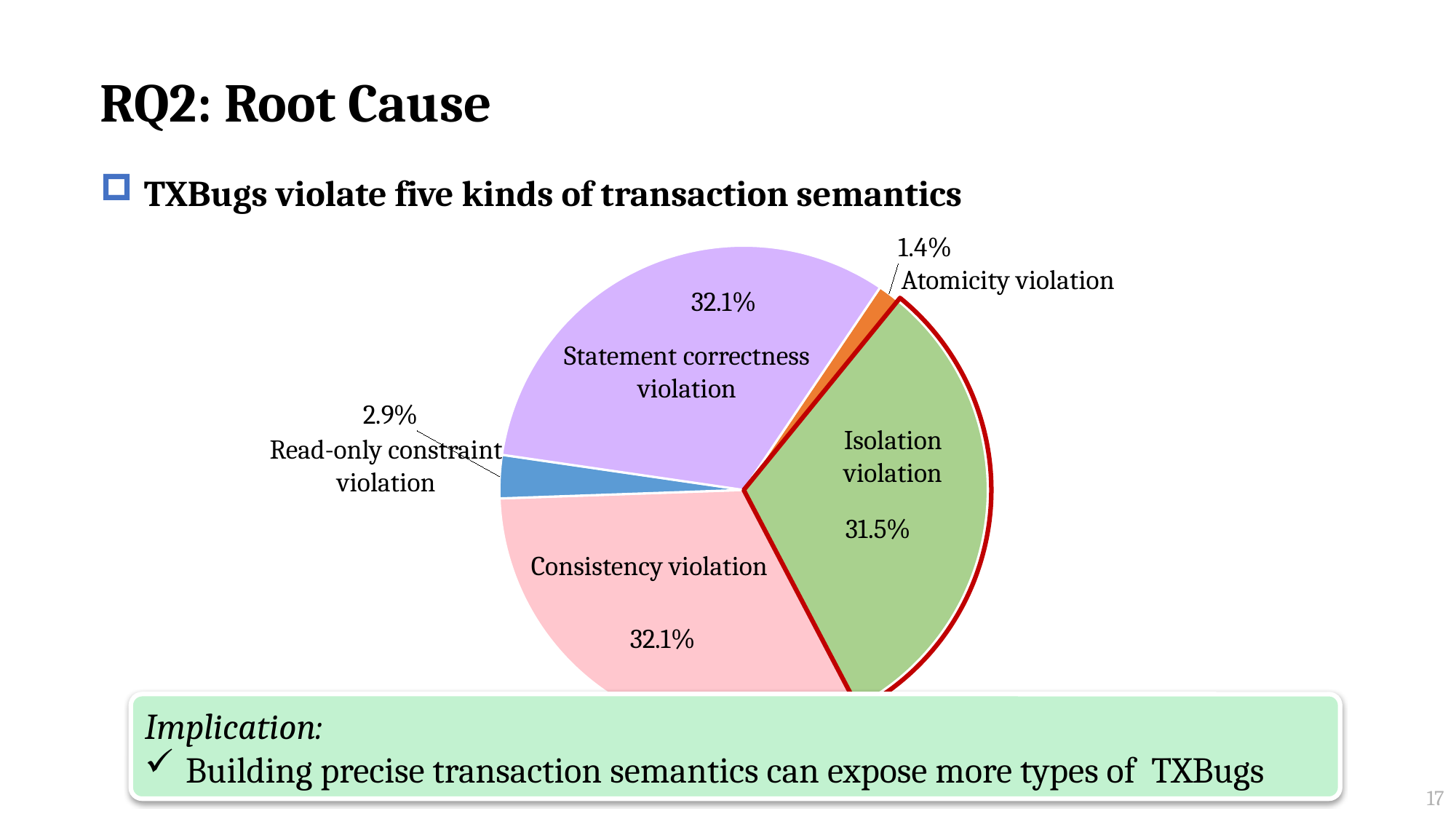
What percentage is shown for Atomicity violation? 1.4% Which slice of the pie is outlined in red? Isolation violation How many categories are shown in the pie chart? 5 What percentage is shown for Consistency violation? 32.1% What is the difference in percentage points between Read-only constraint violation and Atomicity violation? 1.5% What kind of chart is shown on the slide? pie chart What percentage is shown for Statement correctness violation? 32.1% What is the difference in percentage points between Consistency violation and Isolation violation? 0.6% What share of the pie does Isolation violation account for? 31.5% Which category has the smallest slice of the pie? Atomicity violation What percentage is shown for Read-only constraint violation? 2.9% Which is larger, the share for Consistency violation or the share for Isolation violation? Consistency violation